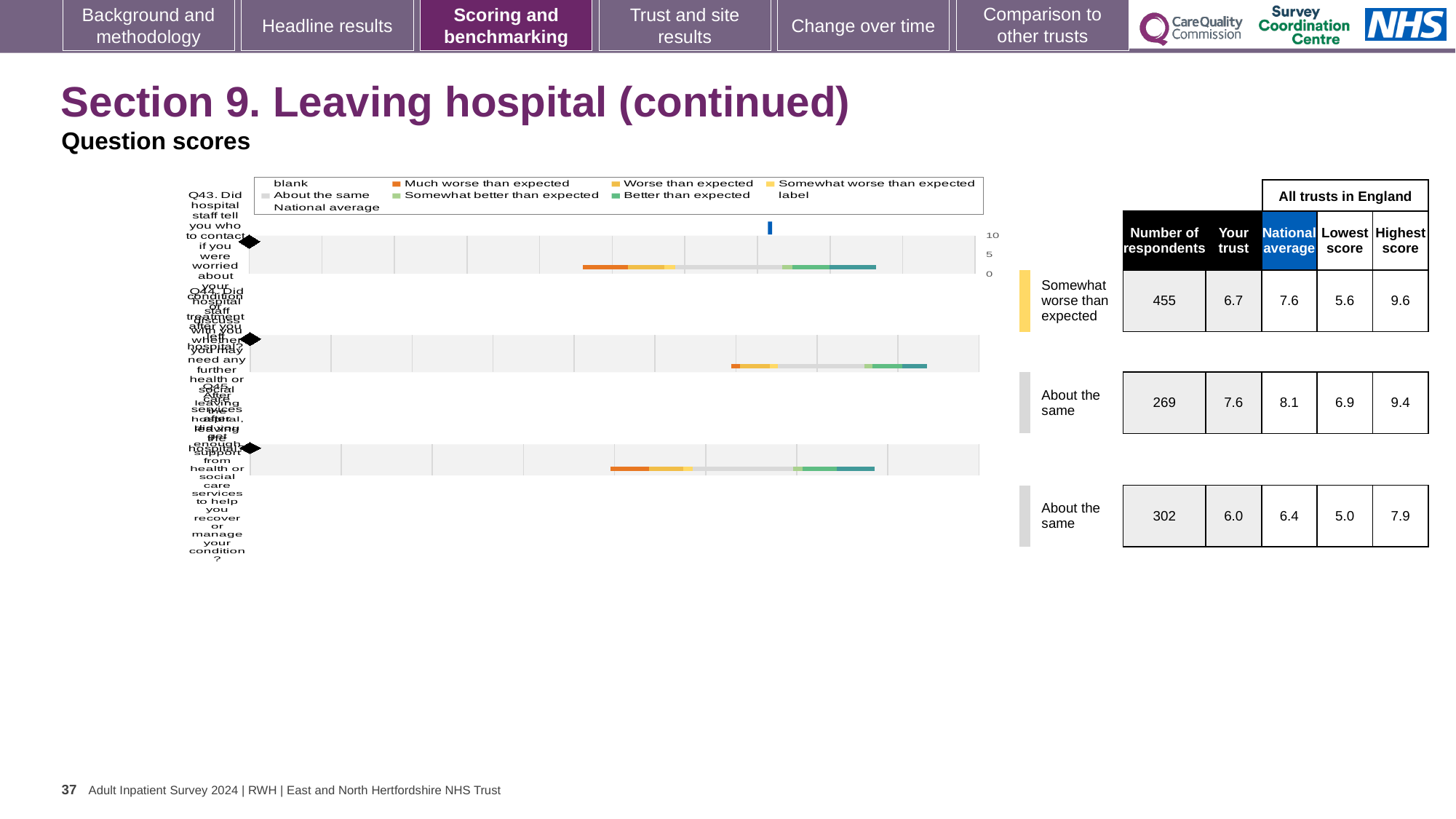
For the first row (Q43), which is larger: the 'Your trust' score or the national average? National average What is the national average score for the first row (Q43)? 7.6 What kind of chart is shown on the slide? bar chart What is the 'Your trust' score for the first row (Q43, who to contact if worried after leaving hospital)? 6.7 What benchmark rating is shown for the third row? About the same What is the highest score among all trusts in England for the second row? 9.4 What benchmark rating is shown for the first row (Q43)? Somewhat worse than expected How many respondents are listed for the first row (Q43)? 455 Which row has the largest number of respondents? The first row (Q43), 455 For the first row (Q43), what is the difference between the highest score (9.6) and the lowest score (5.6)? 4.0 How many question bars are plotted in the chart? 3 What is the lowest score among all trusts in England for the third row? 5.0